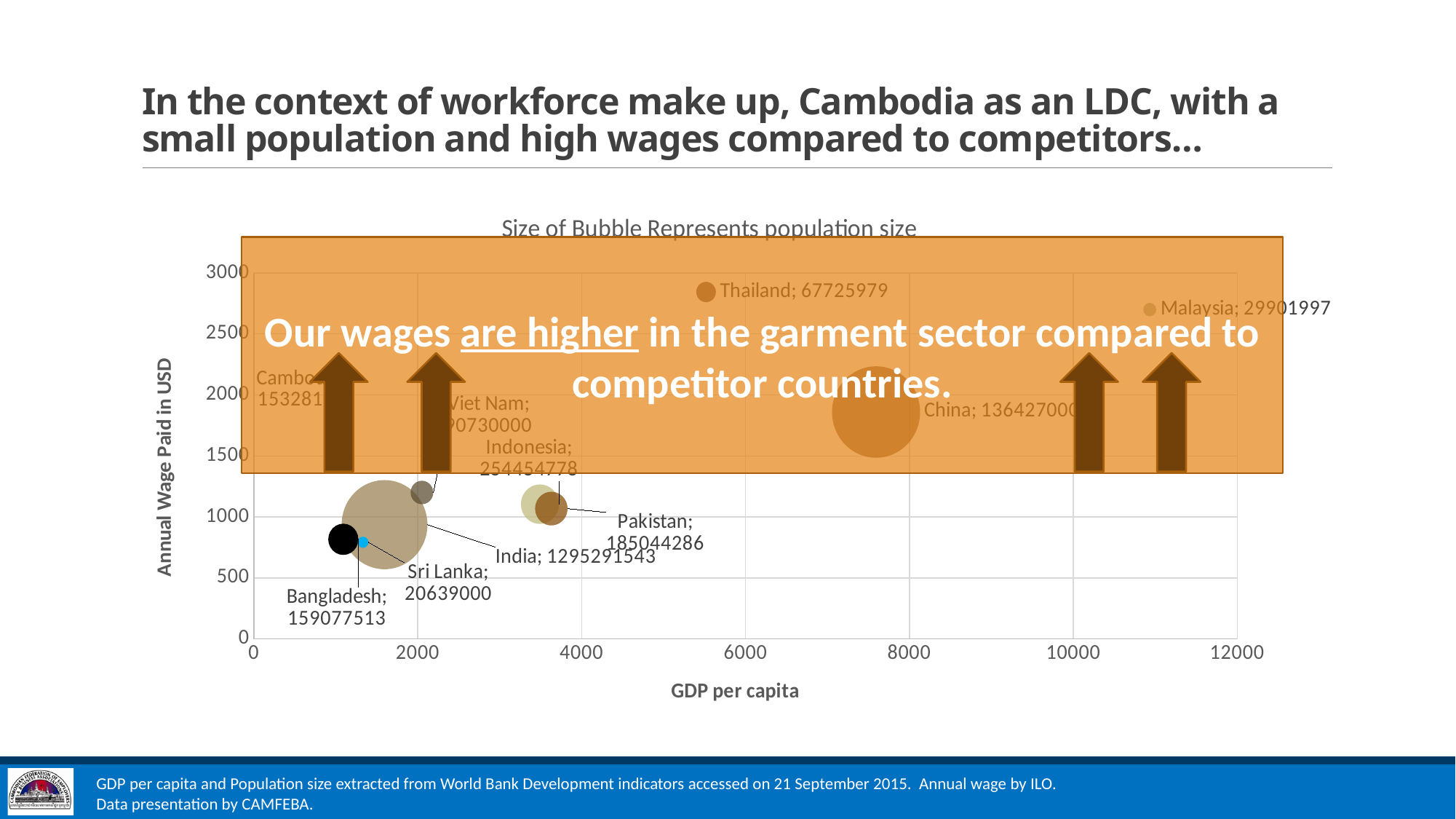
Which country has the highest GDP per capita on the chart? Malaysia What is the label of the vertical axis? Annual Wage Paid in USD What kind of chart is shown on the slide? Bubble chart What population size is shown in the label for Bangladesh? 159077513 Is the GDP per capita for Malaysia greater or less than 10000? greater Is the annual wage for Bangladesh greater or less than 1000? less What population size is shown in the label for Thailand? 67725979 What population size is shown in the label for Sri Lanka? 20639000 What population size is shown in the label for India? 1295291543 What population size is shown in the label for Pakistan? 185044286 What is the chart's title? Size of Bubble Represents population size Is the annual wage for Thailand greater or less than 2500? greater